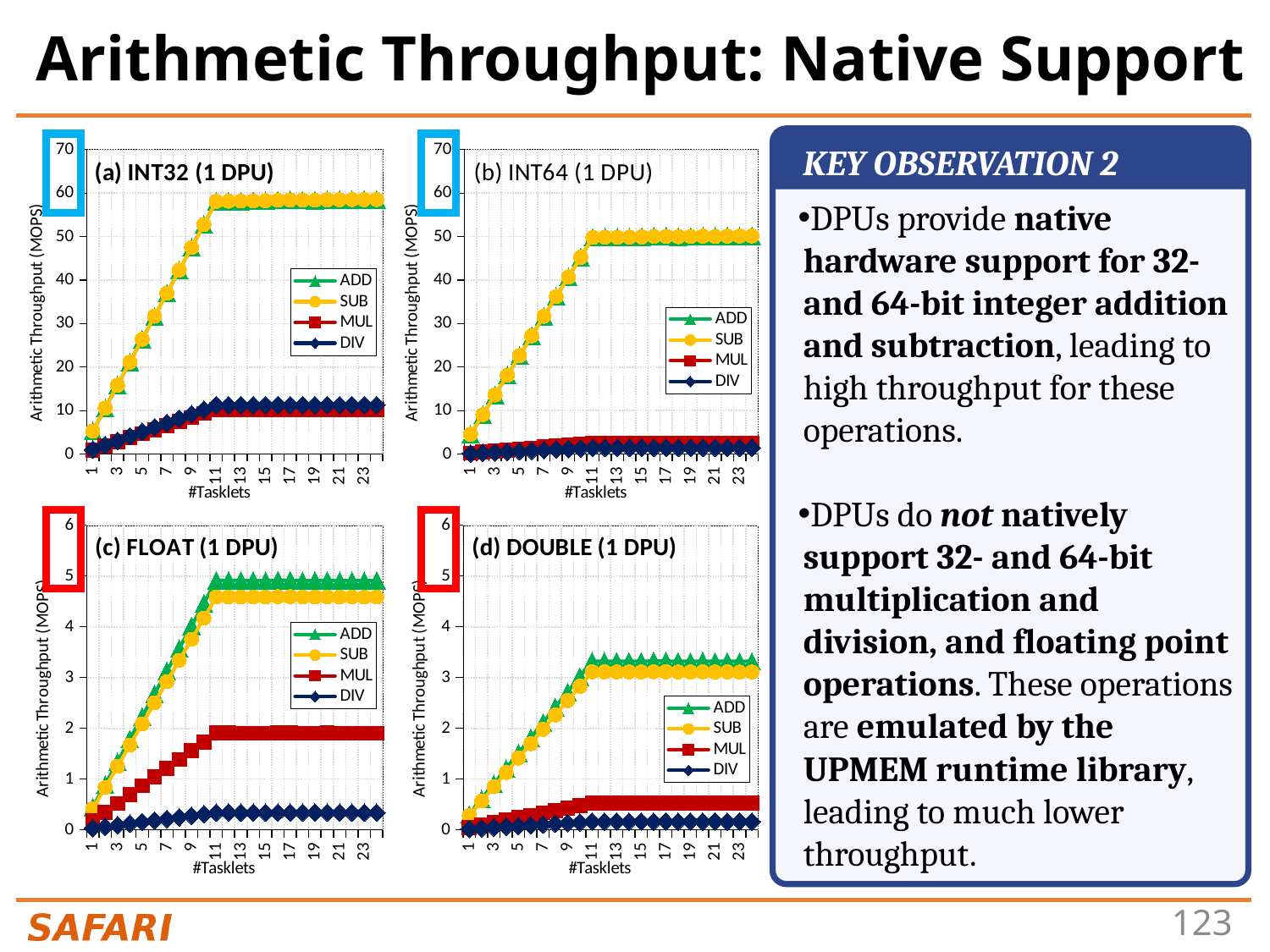
In chart (d) DOUBLE (1 DPU), which is larger at 23 tasklets, ADD or DIV? ADD In chart (d) DOUBLE (1 DPU), is the value for MUL at 23 tasklets greater or less than 1? less In chart (a) INT32 (1 DPU), does the ADD series rise or fall as #Tasklets goes from 1 to 11? rise In chart (c) FLOAT (1 DPU), is the value for ADD at 23 tasklets greater or less than 4? greater What kind of chart is chart (a) INT32 (1 DPU)? line chart How many series does the legend of chart (c) FLOAT (1 DPU) list? 4 In chart (a) INT32 (1 DPU), is the value for ADD at 23 tasklets greater or less than 50? greater In chart (c) FLOAT (1 DPU), which series has the highest throughput at 23 tasklets? ADD In chart (c) FLOAT (1 DPU), which series has the lowest throughput at 23 tasklets? DIV How many charts are shown on the slide? 4 What is the label of the x axis in chart (b) INT64 (1 DPU)? #Tasklets